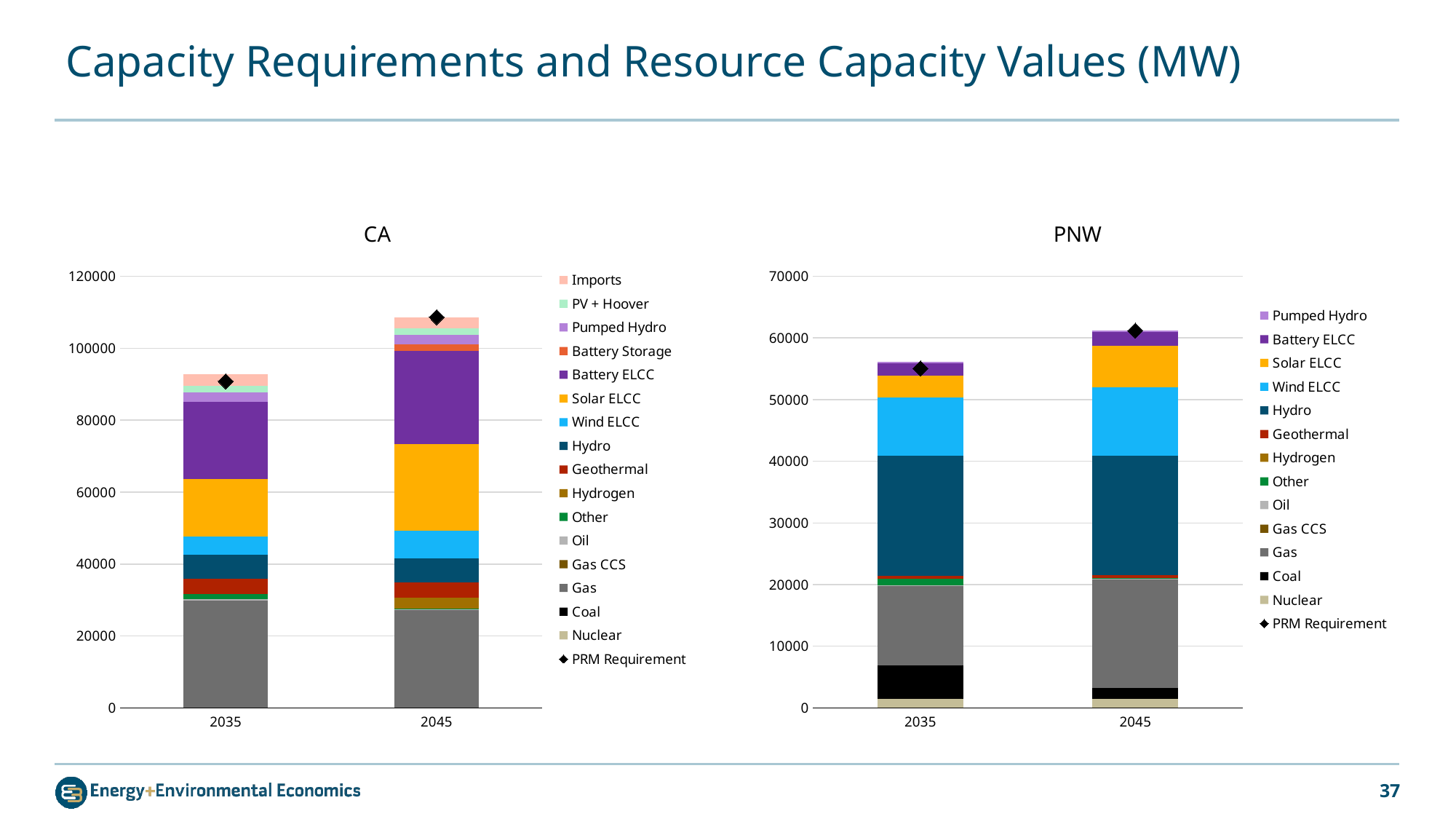
How many entries does the legend of the CA chart list? 17 In the PNW chart, is the total stacked value for 2045 greater or less than 70000? less In the CA chart, is the total stacked value for 2045 greater or less than 100000? greater What are the x-axis categories of the CA chart? 2035 and 2045 How many bars (categories) does the PNW chart show? 2 In the CA chart, which year has the taller stacked bar, 2035 or 2045? 2045 In the PNW chart, which series is shown by the diamond markers? PRM Requirement In the PNW chart, is the total stacked value for 2035 greater or less than 50000? greater What kind of chart is the CA chart? stacked bar chart In the PNW chart, do the total stacked values rise or fall from 2035 to 2045? rise How many entries does the legend of the PNW chart list? 14